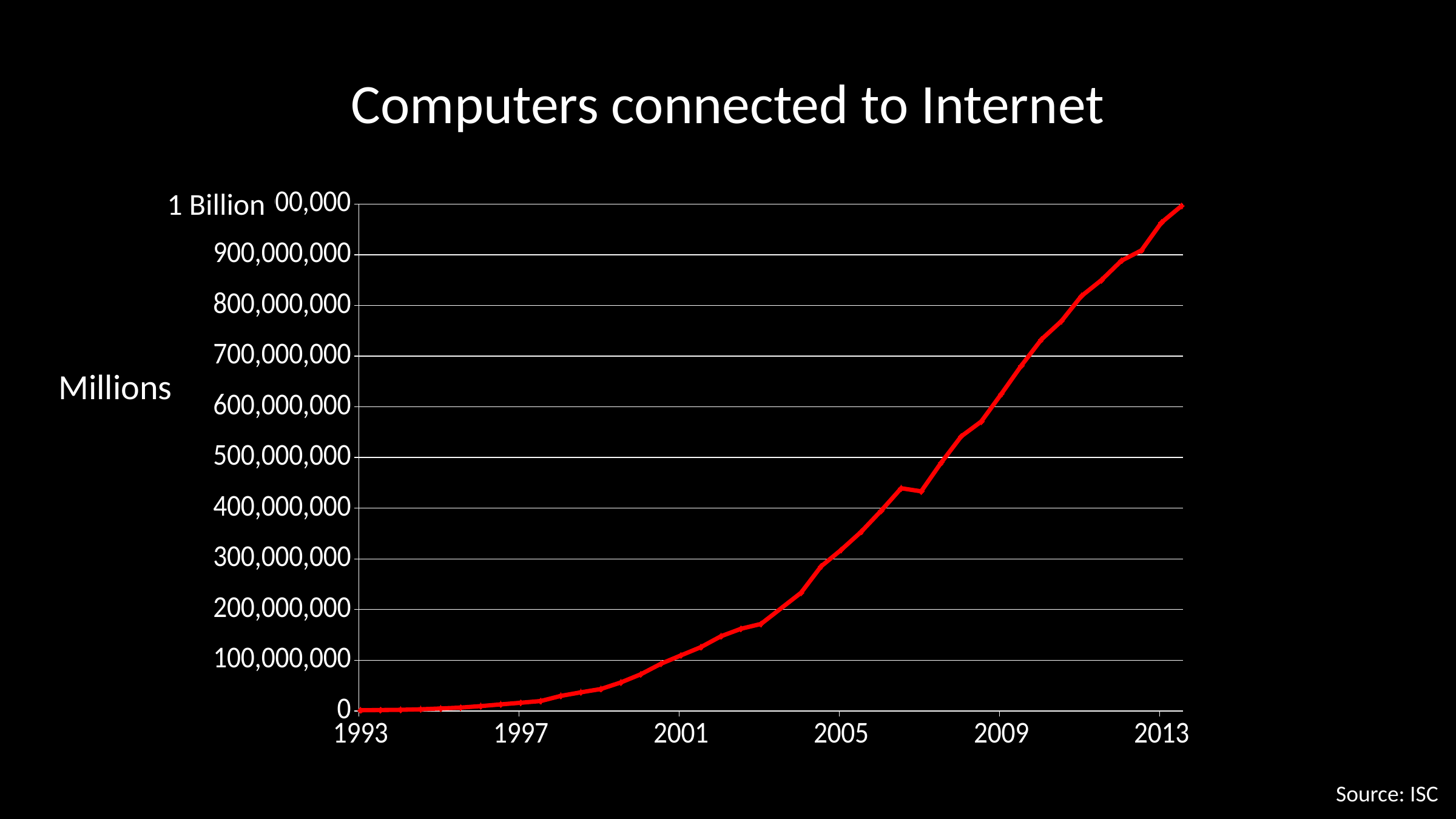
In which year shown on the x axis is the number of computers connected to the Internet highest? 2013 Do the values rise or fall from 1993 to 2013? rise What is the title of the chart? Computers connected to Internet Which year has the larger value, 2005 or 1997? 2005 What source is cited for the chart? ISC In which year shown on the x axis is the number of computers connected to the Internet lowest? 1993 Is the value for 2009 greater or less than 500,000,000? greater Is the value for 2005 greater or less than 200,000,000? greater Which year has the larger value, 2001 or 2009? 2009 Is the value for 2013 greater or less than 900,000,000? greater What kind of chart is shown on the slide? line chart